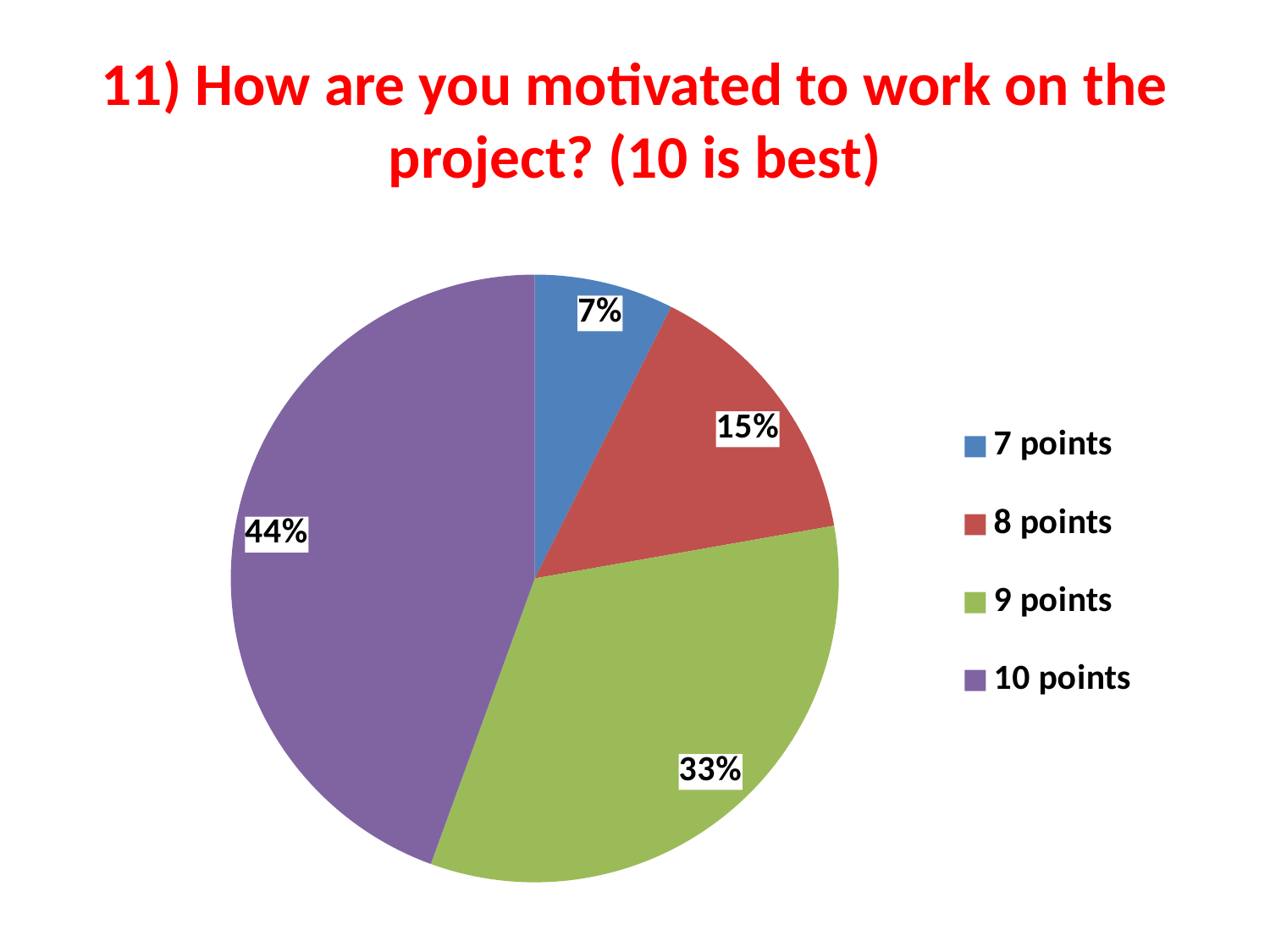
What share of the pie does the 10 points slice have? 44% What share of the pie does the 9 points slice have? 33% What is the difference in percentage points between the 10 points slice and the 9 points slice? 11 What kind of chart is shown on the slide? pie chart What colour is the 9 points slice? green How many categories does the legend list? 4 What share of the pie does the 7 points slice have? 7% Which category has the smallest slice of the pie? 7 points Which slice is larger, 8 points or 9 points? 9 points Which category has the largest slice of the pie? 10 points What is the title of the chart? 11) How are you motivated to work on the project? (10 is best)